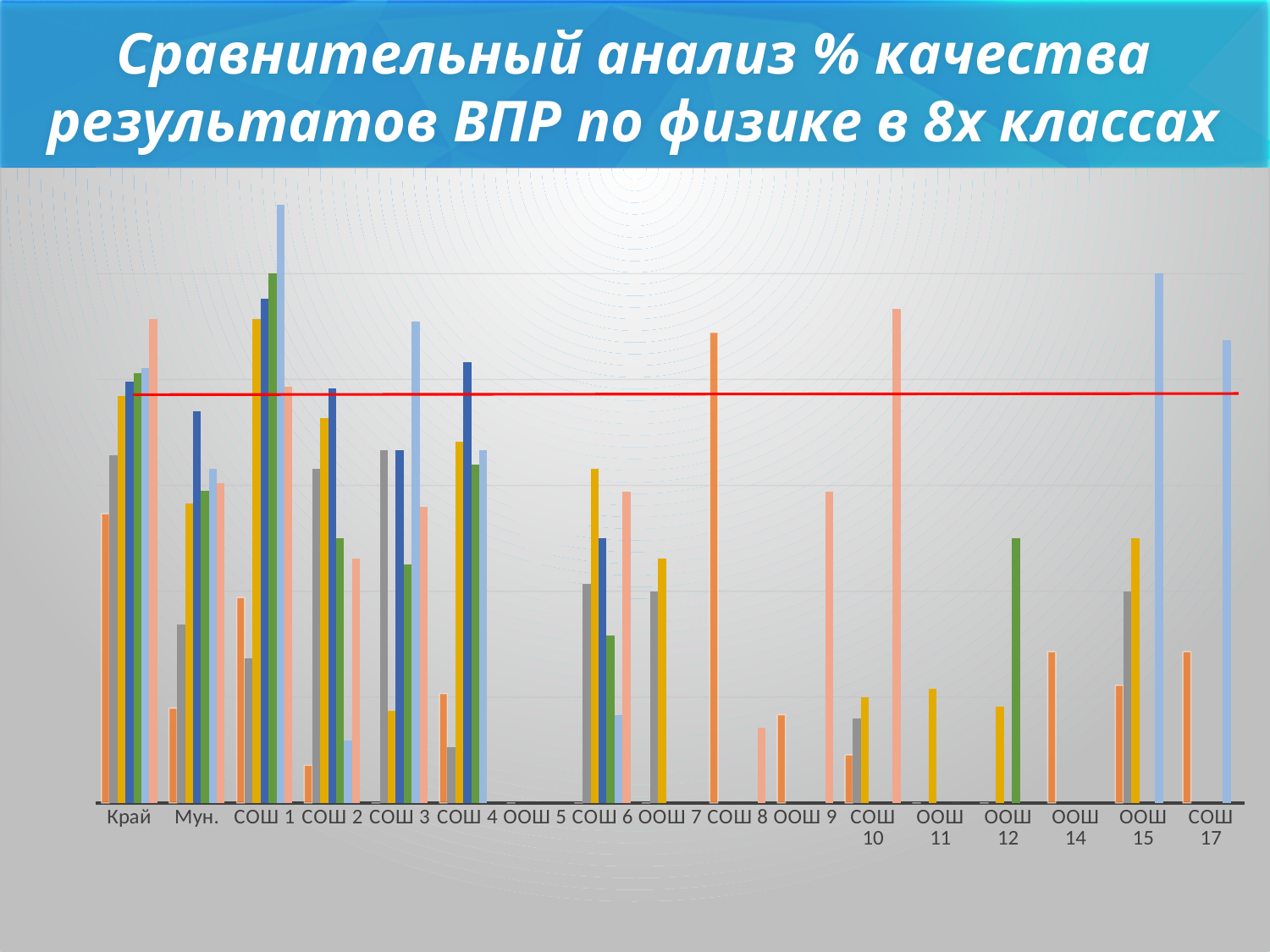
What kind of chart is shown on the slide? bar chart What is the title of the slide containing the chart? Сравнительный анализ % качества результатов ВПР по физике в 8х классах Which category has the taller bar: Край or Мун.? Край How many categories are shown along the x axis of the chart? 17 Which category has the taller bar: ООШ 15 or ООШ 14? ООШ 15 Which category has no bars plotted at all? ООШ 5 Which category has the taller bar: СОШ 17 or ООШ 12? СОШ 17 What colour is the horizontal reference line drawn across the chart? red Which category contains the tallest bar in the chart? СОШ 1